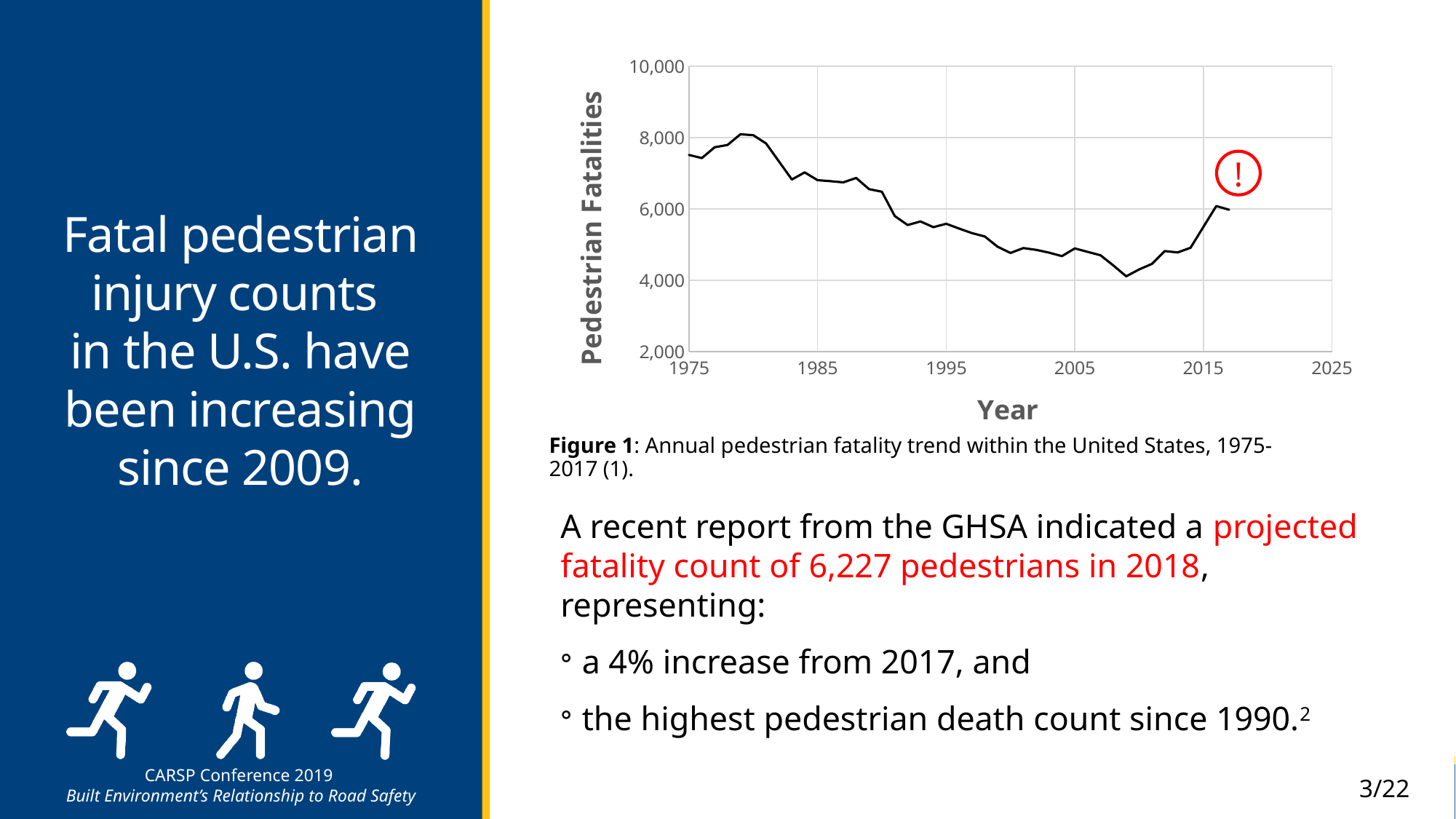
Is the value for 2005 greater or less than 6,000? less Which is larger, the value for 1985 or the value for 2005? 1985 Do pedestrian fatalities rise or fall between 1980 and 2009? fall Is the value for 1975 greater or less than 6,000? greater Is the value for 1985 greater or less than 6,000? greater What kind of chart is shown on the slide? Line chart What is the label of the y axis of the chart? Pedestrian Fatalities What is the label of the x axis of the chart? Year Do pedestrian fatalities rise or fall between 2009 and 2017? rise